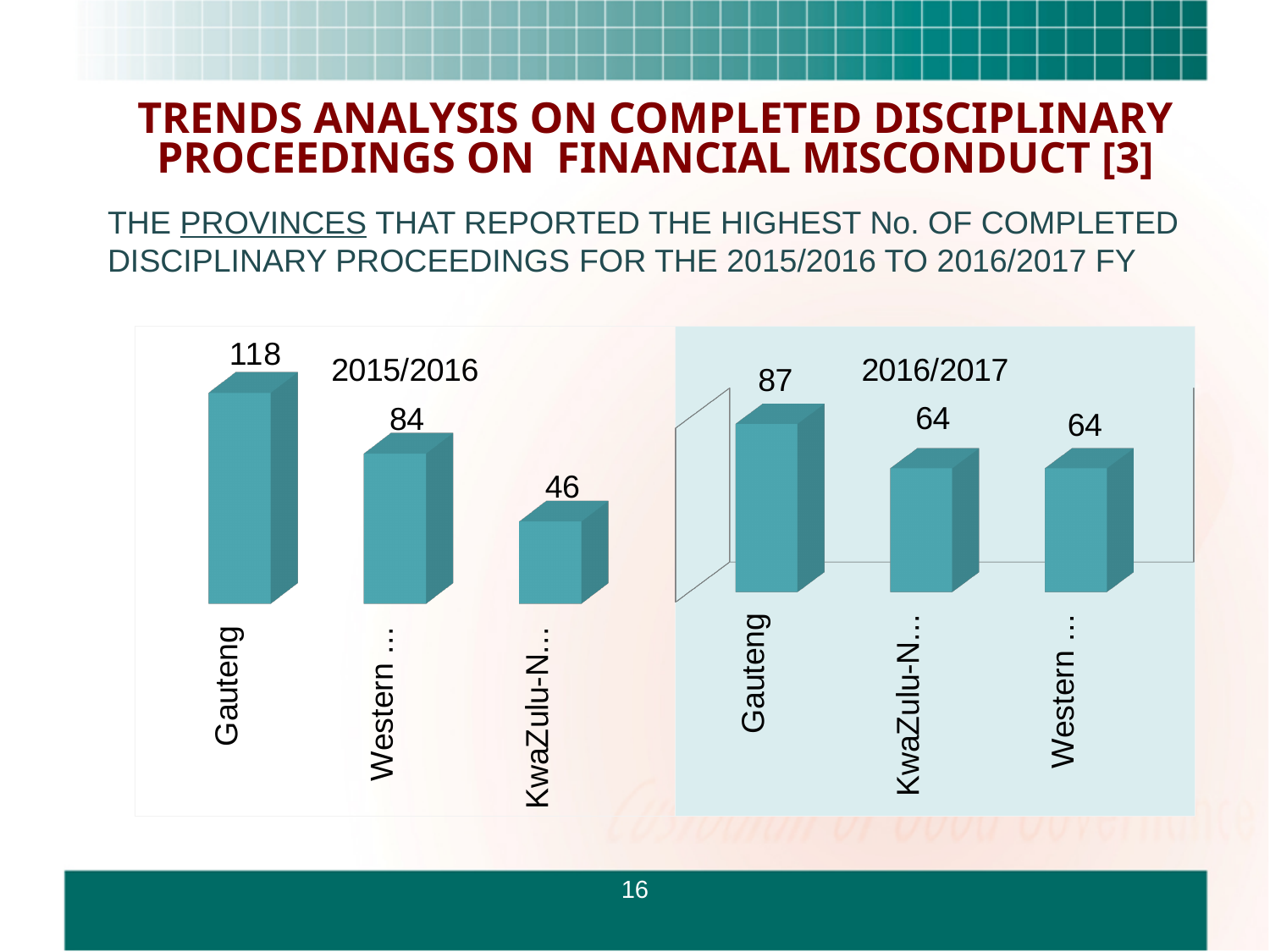
In the 2015/2016 chart, what is the value for Gauteng? 118 In the 2015/2016 chart, which bar has the lowest value? KwaZulu-N... In the 2015/2016 chart, what is the value for the bar labelled 'KwaZulu-N...'? 46 What is the difference between Gauteng's value in the 2015/2016 chart and its value in the 2016/2017 chart? 31 In the 2015/2016 chart, what is the difference between the Gauteng bar and the 'Western ...' bar? 34 In the 2016/2017 chart, what is the value for the bar labelled 'Western ...'? 64 What type of chart is used for the 2015/2016 data? Bar chart In the 2016/2017 chart, which province has the highest value? Gauteng In the 2015/2016 chart, which province has the highest value? Gauteng Is Gauteng's value larger in the 2015/2016 chart or in the 2016/2017 chart? 2015/2016 How many bars are shown in the 2016/2017 chart? 3 In the 2016/2017 chart, what is the value for Gauteng? 87